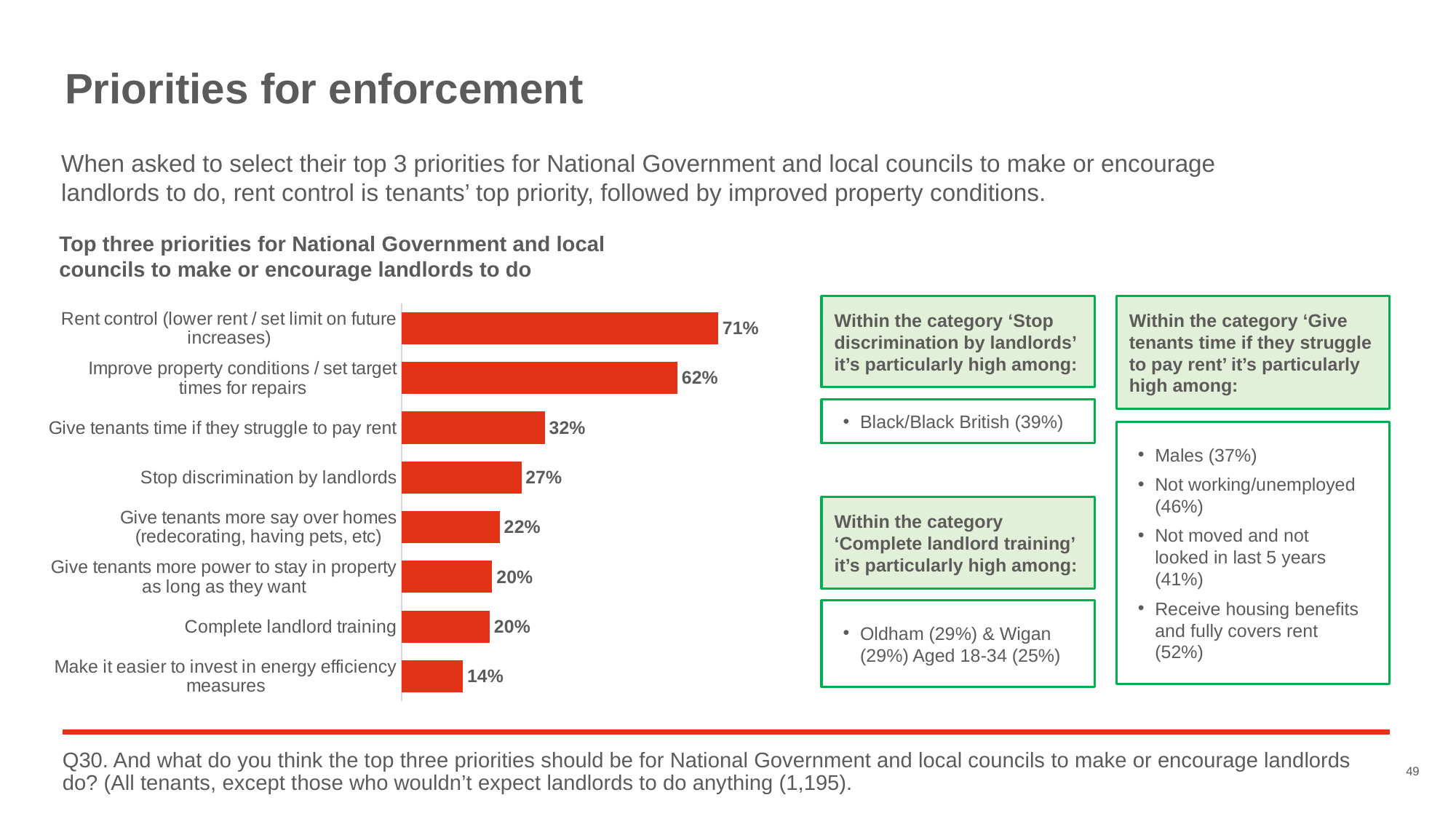
What is the difference in percentage points between 'Rent control' and 'Improve property conditions / set target times for repairs'? 9 percentage points What is the value shown for 'Make it easier to invest in energy efficiency measures'? 14% Which priority has the lowest percentage in the chart? Make it easier to invest in energy efficiency measures What is the value shown for 'Give tenants time if they struggle to pay rent'? 32% How many priorities (categories) are shown in the bar chart? 8 What is the title of the chart on the slide? Top three priorities for National Government and local councils to make or encourage landlords to do What percentage of tenants selected 'Rent control (lower rent / set limit on future increases)' as a top three priority? 71% What type of chart is used to show the top three priorities? Bar chart What is the difference in percentage points between 'Give tenants time if they struggle to pay rent' and 'Complete landlord training'? 12 percentage points What is the value shown for 'Stop discrimination by landlords'? 27% Which priority has the highest percentage in the chart? Rent control (lower rent / set limit on future increases) Which has a higher value: 'Give tenants more say over homes (redecorating, having pets, etc)' or 'Stop discrimination by landlords'? Stop discrimination by landlords